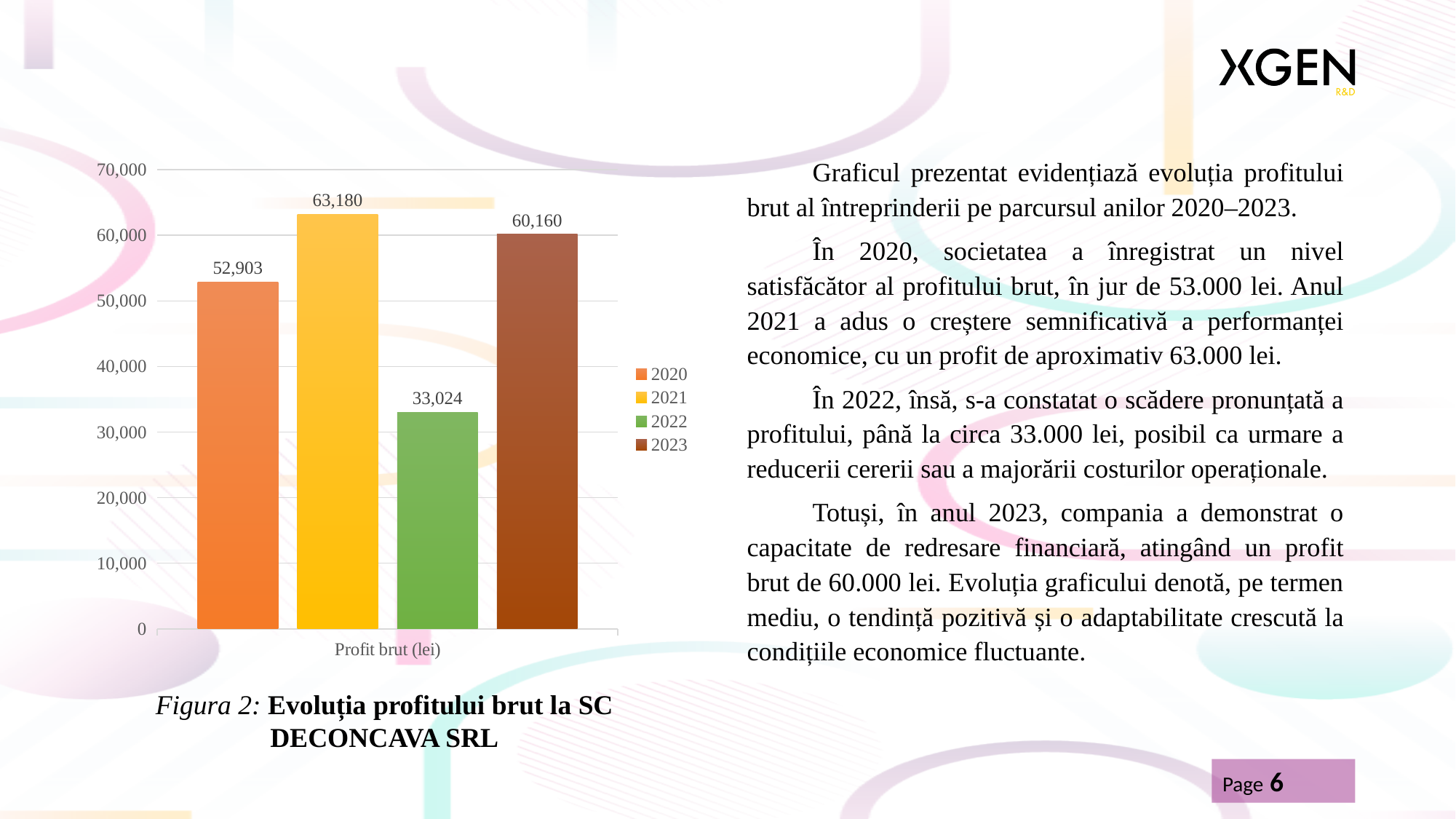
Which year has the lowest gross profit? 2022 What kind of chart is shown on the slide? Bar chart What is the x-axis category label shown under the bars? Profit brut (lei) What is the difference between the gross profit in 2021 and in 2022? 30,156 What is the gross profit (Profit brut) value for 2020? 52,903 Which is larger, the gross profit for 2020 or for 2023? 2023 What is the gross profit value for 2021? 63,180 How many series does the legend list? 4 What is the gross profit value for 2023? 60,160 Which year has the highest gross profit? 2021 What is the gross profit value for 2022? 33,024 What is the difference between the gross profit in 2023 and in 2020? 7,257